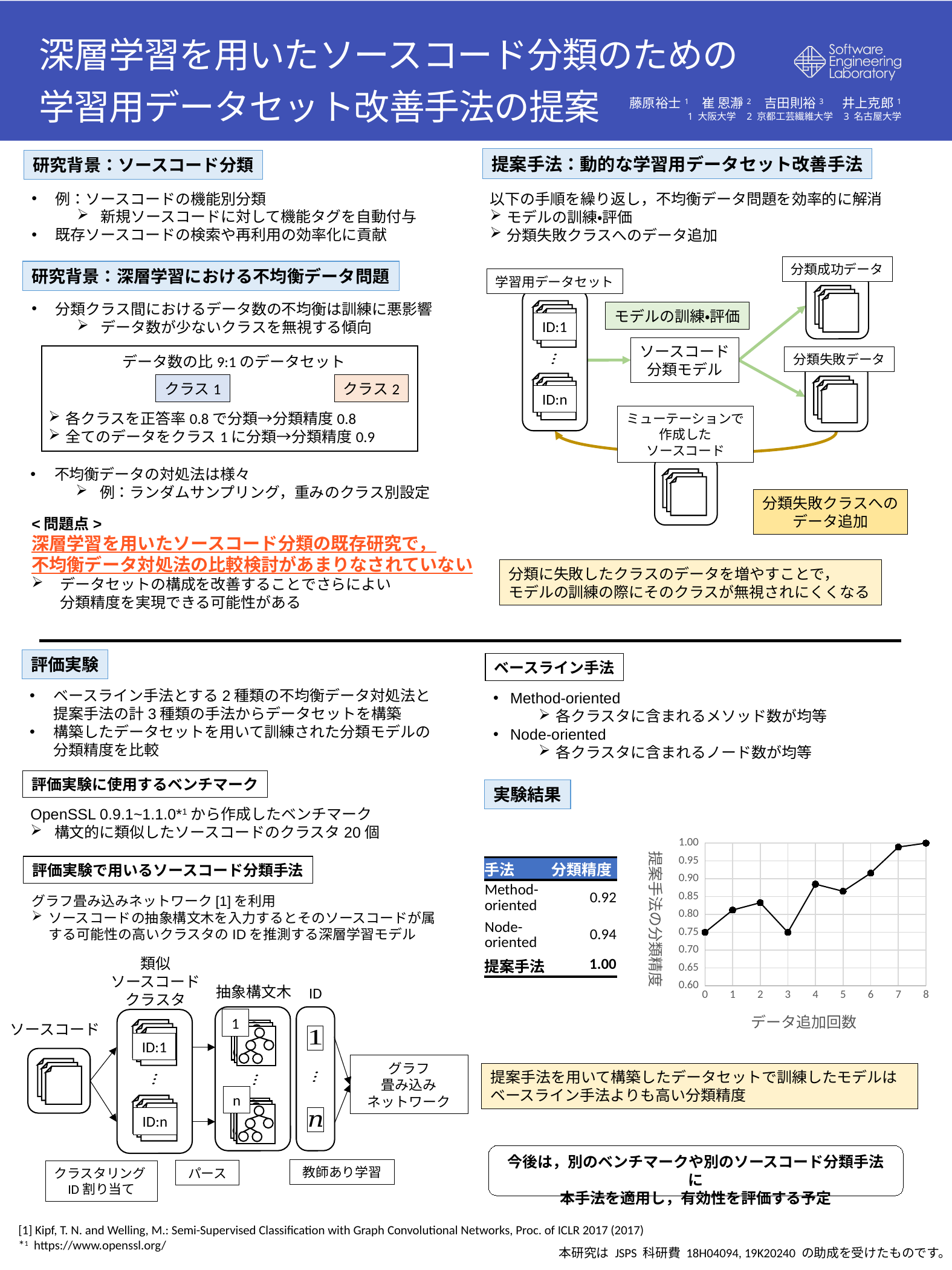
What kind of chart is shown in the 実験結果 section? line chart Is the plotted accuracy at データ追加回数 = 7 greater or less than 0.95? greater At which value of データ追加回数 is the plotted accuracy highest? 8 What is the plotted accuracy at データ追加回数 = 8? 1.00 Which has the higher plotted accuracy: データ追加回数 = 3 or データ追加回数 = 4? 4 What is the label of the y axis of the line chart? 提案手法の分類精度 Overall, does the plotted accuracy rise or fall as データ追加回数 increases from 0 to 8? rise Is the plotted accuracy at データ追加回数 = 5 greater or less than 0.90? less Is the plotted accuracy at データ追加回数 = 0 greater or less than 0.80? less How many data points are plotted on the line chart? 9 What is the label of the x axis of the line chart? データ追加回数